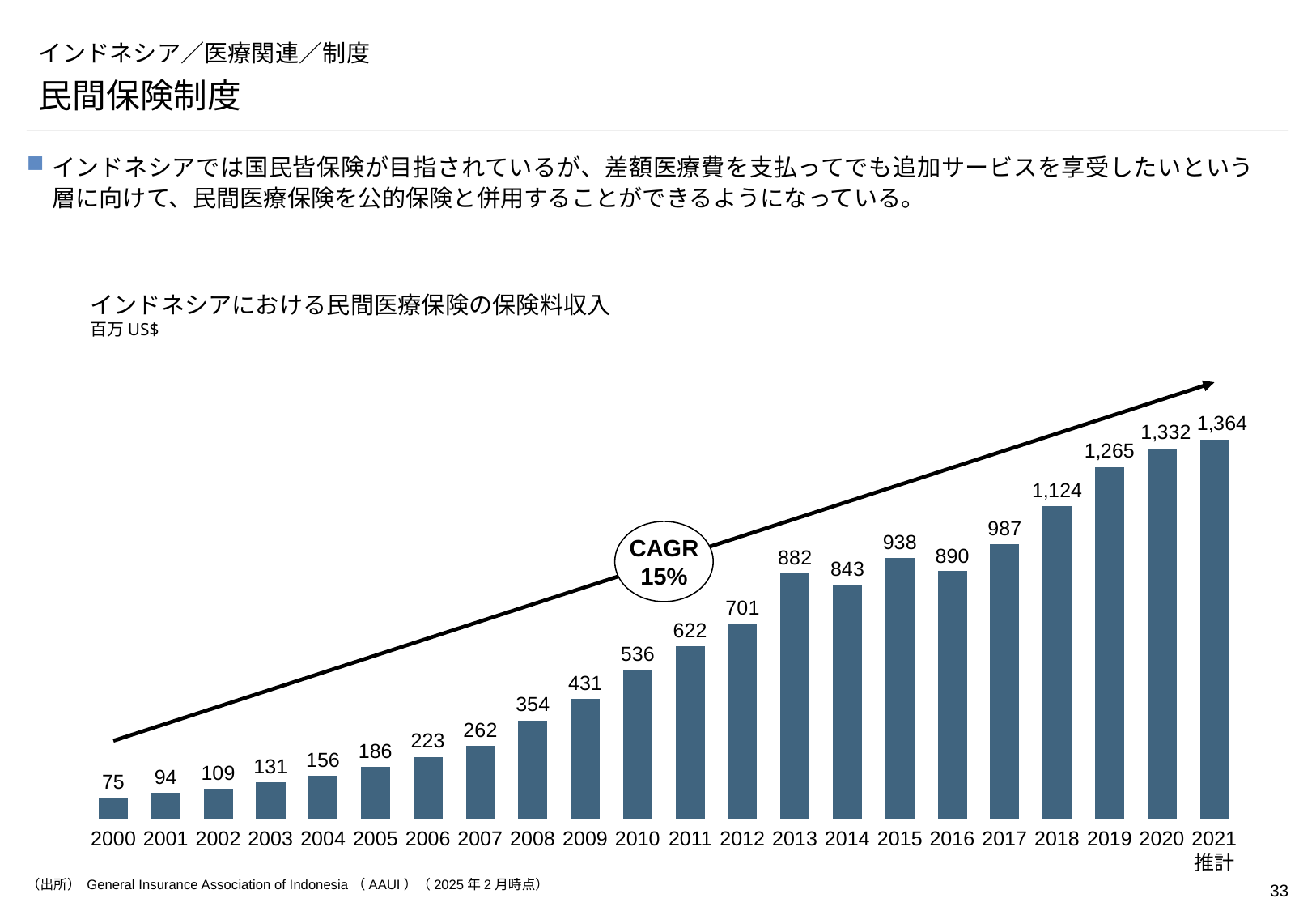
What is the difference between the values for 2021 and 2020? 32 What is the value for 2010 in the chart? 536 What kind of chart is shown on the slide? Bar chart Do the values generally rise or fall from 2000 to 2021? Rise Which year has the highest value in the chart? 2021 What is the value for 2018 in the chart? 1,124 Which is larger, the value for 2015 or the value for 2016? 2015 What CAGR is shown in the circle on the chart? 15% Which year has the lowest value in the chart? 2000 What is the value for 2000 in the chart? 75 How many years are shown on the x axis of the chart? 22 What is the difference between the values for 2013 and 2014? 39